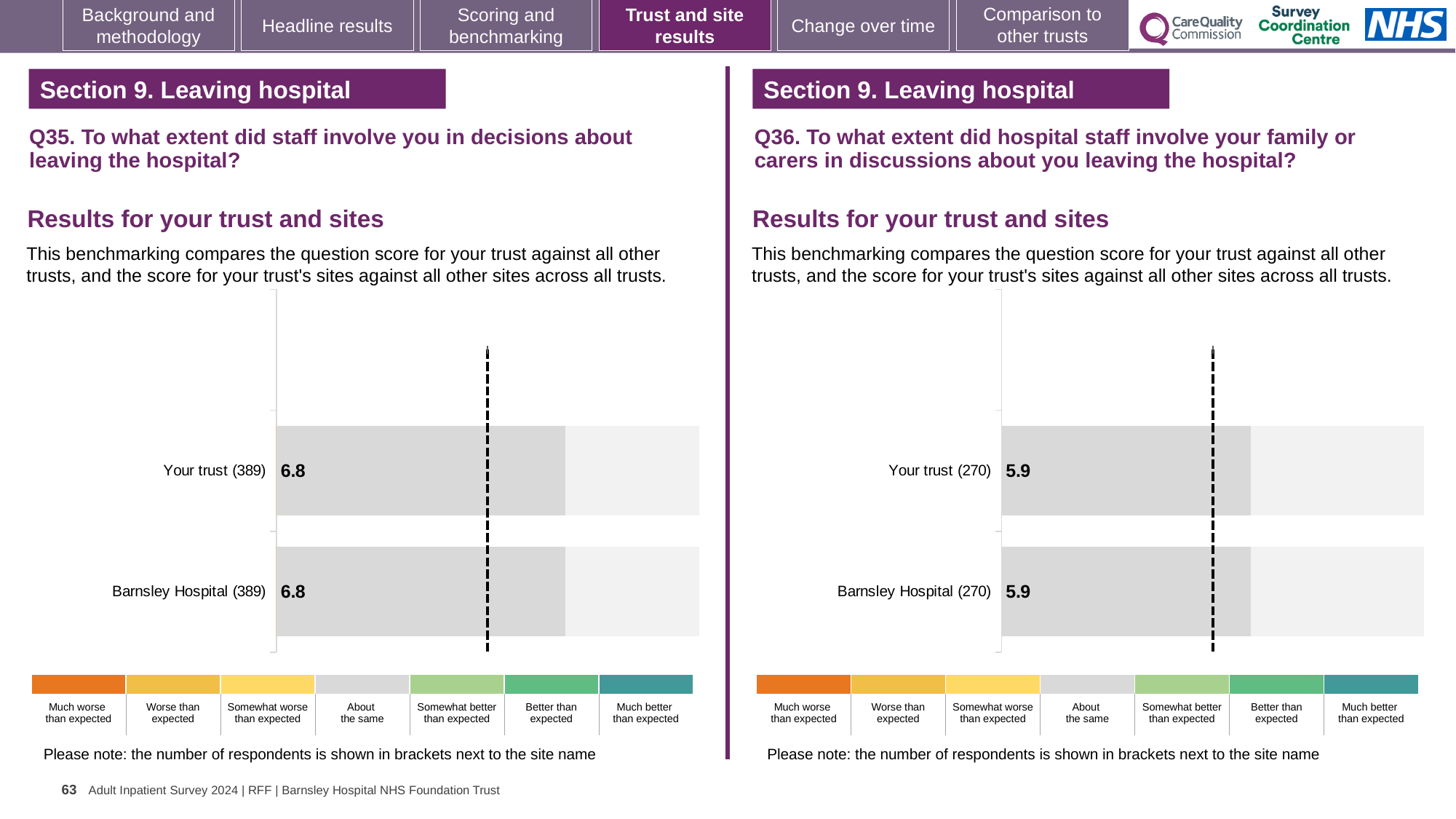
In the Q35 chart on the left, what is the score for Your trust? 6.8 In the Q36 chart on the right, what is the difference between the score for Your trust and the score for Barnsley Hospital? 0 In the Q36 chart on the right, what is the score for Barnsley Hospital? 5.9 How many bars are plotted in the Q35 chart on the left? 2 How many bars are plotted in the Q36 chart on the right? 2 In the Q35 chart on the left, what is the difference between the score for Your trust and the score for Barnsley Hospital? 0 What kind of chart is the Q35 chart on the left? Bar chart In the Q36 chart on the right, what is the score for Your trust? 5.9 Is the score for Your trust in the Q35 chart on the left larger or smaller than the score for Your trust in the Q36 chart on the right? Larger In the Q36 chart on the right, how many respondents are shown in brackets next to Barnsley Hospital? 270 In the Q35 chart on the left, what is the score for Barnsley Hospital? 6.8 In the Q35 chart on the left, how many respondents are shown in brackets next to Your trust? 389